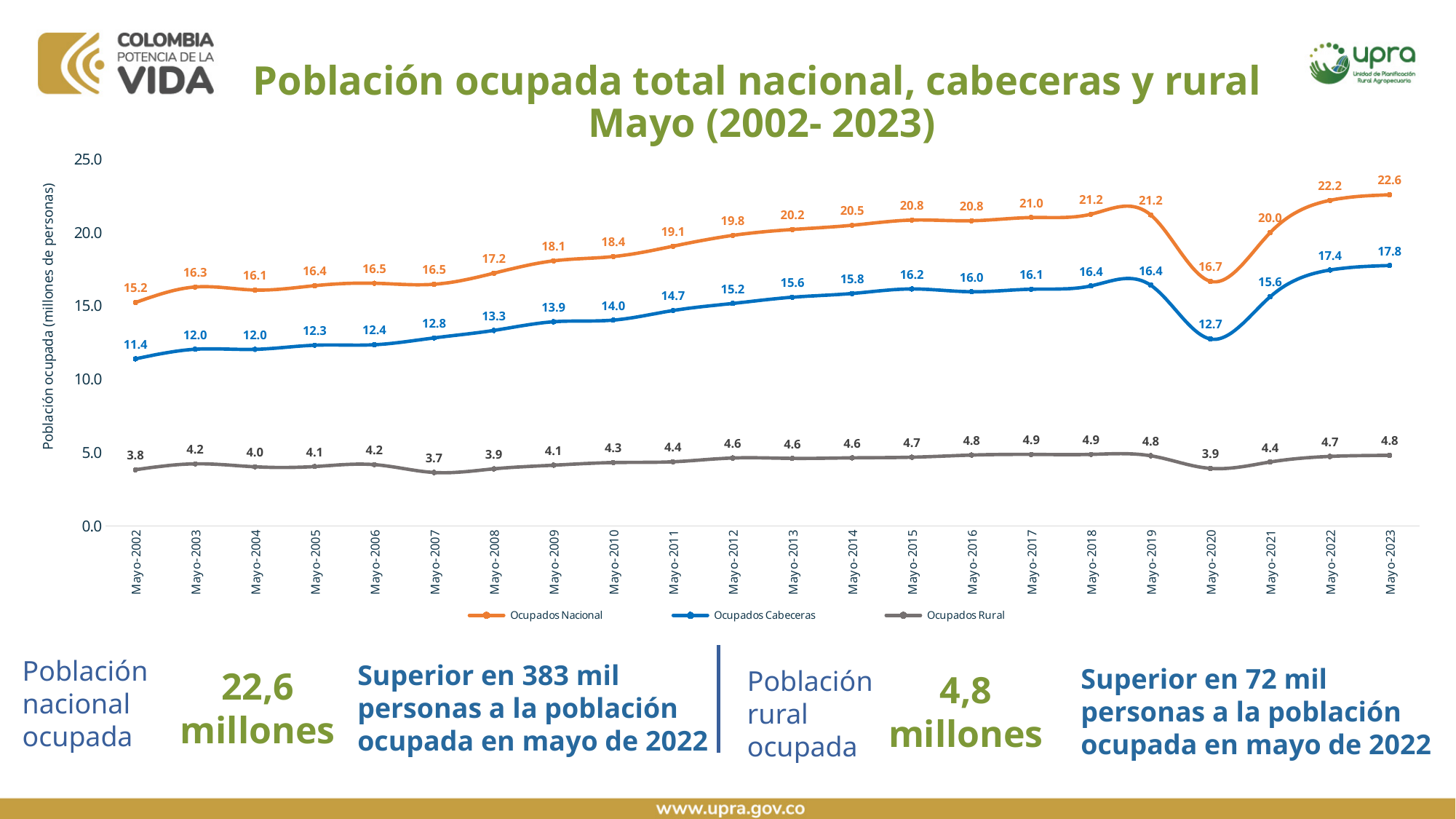
In which year does the Ocupados Nacional series reach its highest value? Mayo-2023 What is the value of Ocupados Rural in Mayo-2007? 3.7 What is the value of Ocupados Cabeceras in Mayo-2023? 17.8 How many series does the legend list? 3 What kind of chart is shown on the slide? Line chart What is the difference between Ocupados Nacional and Ocupados Cabeceras in Mayo-2023? 4.8 Which is larger for Ocupados Cabeceras: the value in Mayo-2019 or in Mayo-2021? Mayo-2019 In which year does the Ocupados Cabeceras series have its lowest value? Mayo-2002 How many years (data points) are plotted along the x axis? 22 In which year does the Ocupados Rural series have its lowest value? Mayo-2007 What is the difference between the Ocupados Nacional values for Mayo-2023 and Mayo-2022? 0.4 What is the value of Ocupados Nacional in Mayo-2020? 16.7